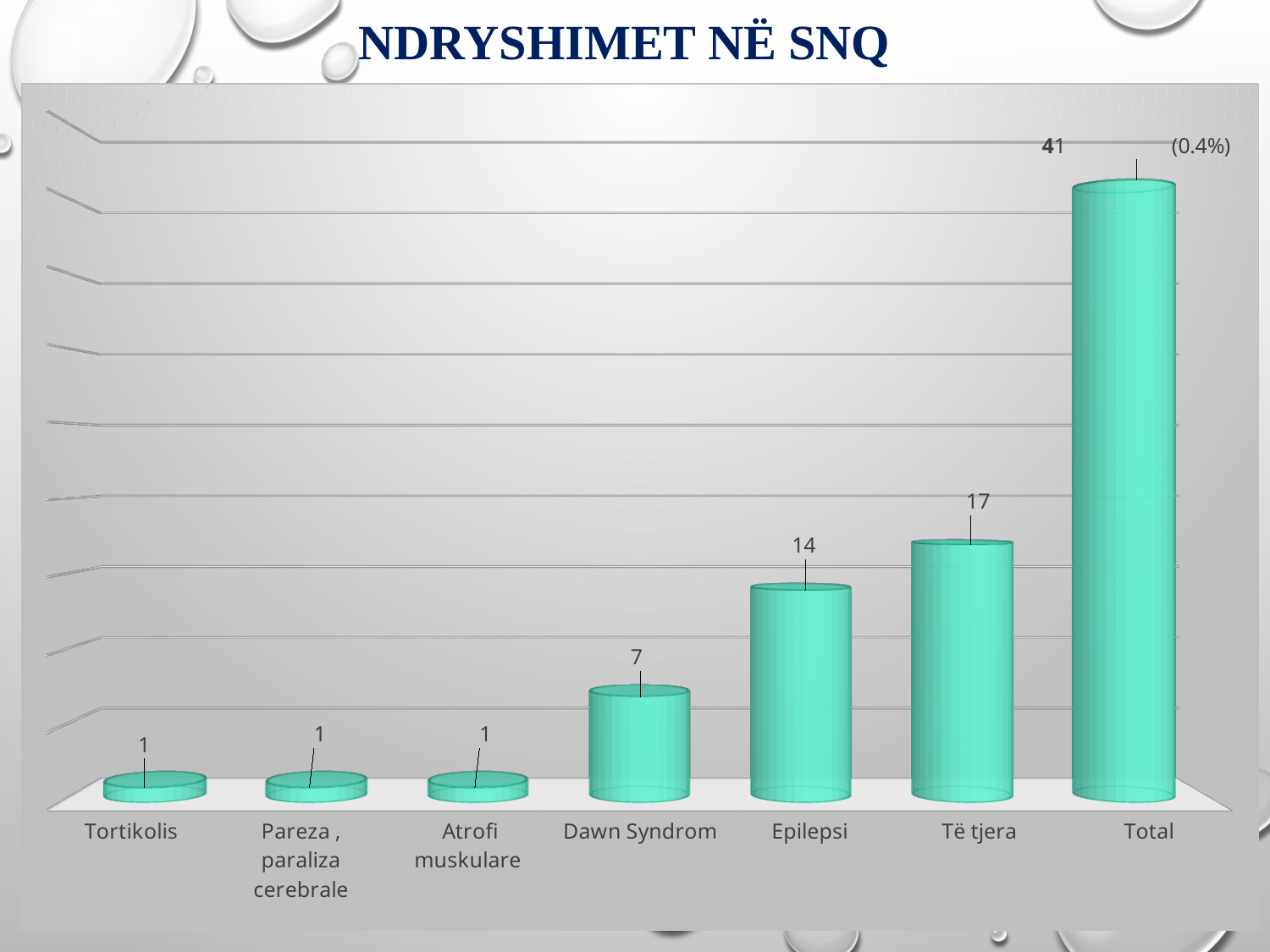
What is the difference between the values for Të tjera and Epilepsi? 3 How many categories are shown on the x axis? 7 What is the value for Epilepsi? 14 What is the title of the slide above the chart? NDRYSHIMET NË SNQ What is the difference between the values for Epilepsi and Dawn Syndrom? 7 Which category has the highest value? Total What is the value for Dawn Syndrom? 7 Which is larger, the value for Dawn Syndrom or the value for Epilepsi? Epilepsi What is the value for Total? 41 What is the value for Të tjera? 17 What is the value for Tortikolis? 1 Excluding Total, which category has the highest value? Të tjera